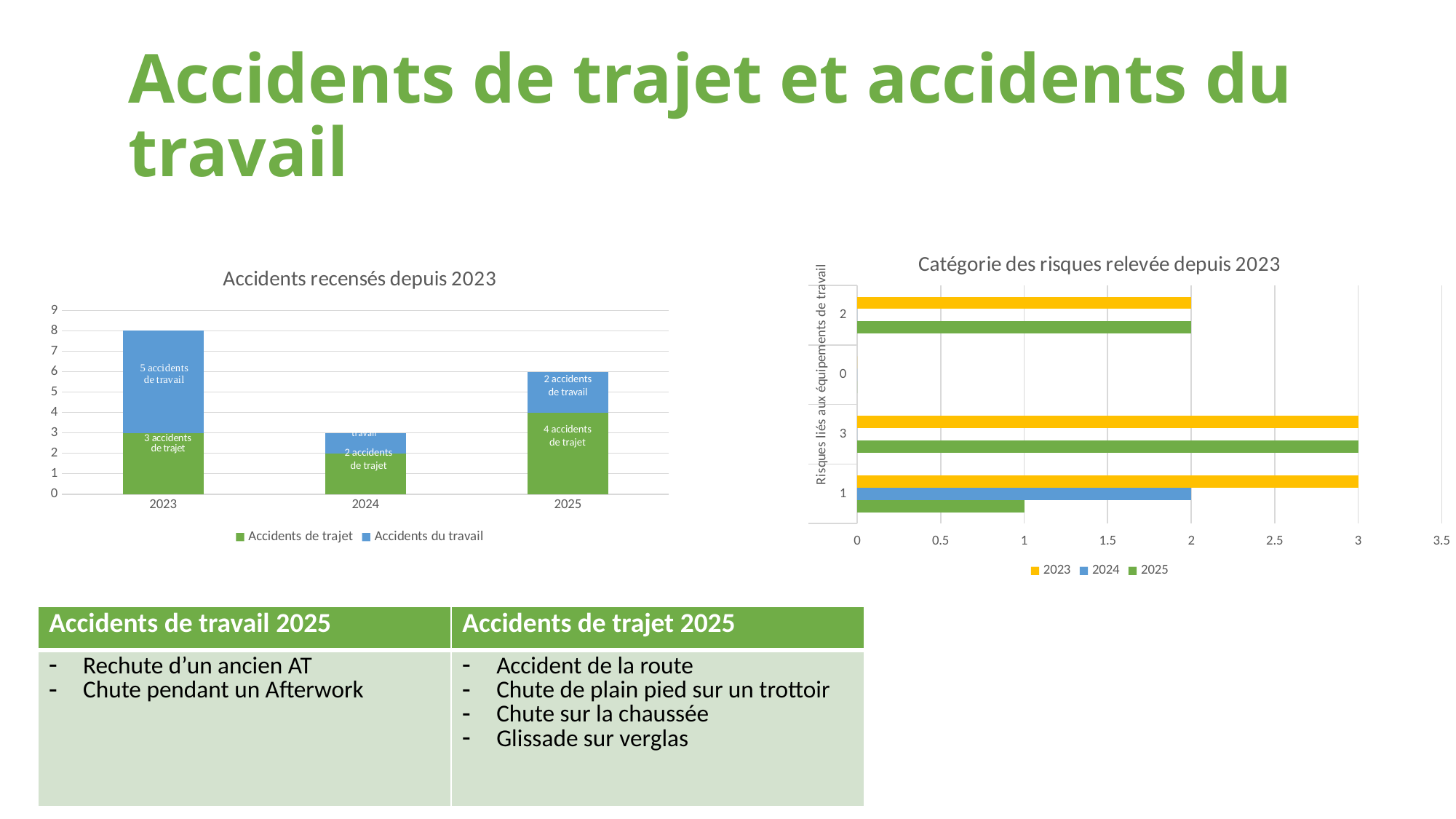
In the chart titled "Accidents recensés depuis 2023", what is the total height of the stacked bar for 2023? 8 In the chart titled "Catégorie des risques relevée depuis 2023", how many series does the legend list? 3 In the chart titled "Accidents recensés depuis 2023", how many accidents de trajet were recorded in 2024? 2 In the chart titled "Accidents recensés depuis 2023", how many accidents de travail were recorded in 2025? 2 In the chart titled "Accidents recensés depuis 2023", how many accidents de trajet were recorded in 2023? 3 In the chart titled "Accidents recensés depuis 2023", which year has the tallest stacked bar? 2023 In the chart titled "Accidents recensés depuis 2023", which year has the shortest stacked bar? 2024 In the chart titled "Accidents recensés depuis 2023", how many series does the legend list? 2 In the chart titled "Accidents recensés depuis 2023", what is the difference between the number of accidents de travail in 2023 and in 2025? 3 In the chart titled "Catégorie des risques relevée depuis 2023", which colour represents the 2023 series? Yellow In the chart titled "Accidents recensés depuis 2023", what is the total height of the stacked bar for 2025? 6 What kind of chart is the chart titled "Catégorie des risques relevée depuis 2023"? Bar chart